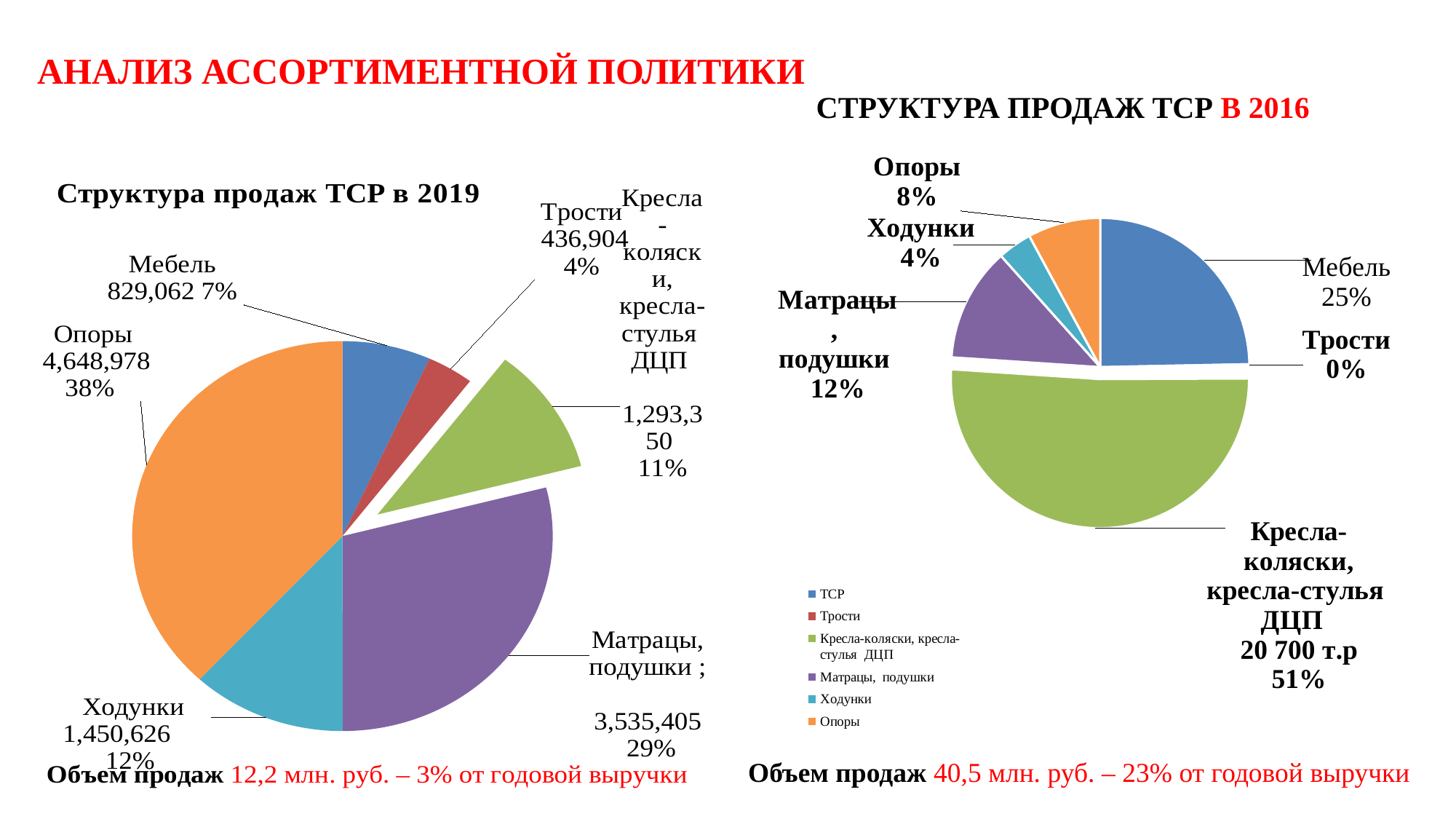
In the chart "СТРУКТУРА ПРОДАЖ ТСР В 2016", how many entries does the legend list? 6 In the chart "Структура продаж ТСР в 2019", what is the value for Опоры? 4,648,978 In the chart "СТРУКТУРА ПРОДАЖ ТСР В 2016", what colour is the slice for Матрацы, подушки? Purple What type of chart is "Структура продаж ТСР в 2019"? Pie chart In the chart "Структура продаж ТСР в 2019", what is the difference between the values for Ходунки and Мебель? 621,564 In the chart "Структура продаж ТСР в 2019", which category has the largest slice? Опоры In the chart "СТРУКТУРА ПРОДАЖ ТСР В 2016", which category has the largest slice? Кресла-коляски, кресла-стулья ДЦП In the chart "Структура продаж ТСР в 2019", which category has the smallest slice? Трости In the chart "Структура продаж ТСР в 2019", what share of the pie is Матрацы, подушки? 29% In the chart "Структура продаж ТСР в 2019", how many categories are shown? 6 In the chart "СТРУКТУРА ПРОДАЖ ТСР В 2016", what share of the pie is Мебель? 25% In the chart "СТРУКТУРА ПРОДАЖ ТСР В 2016", which is larger, Опоры or Ходунки? Опоры